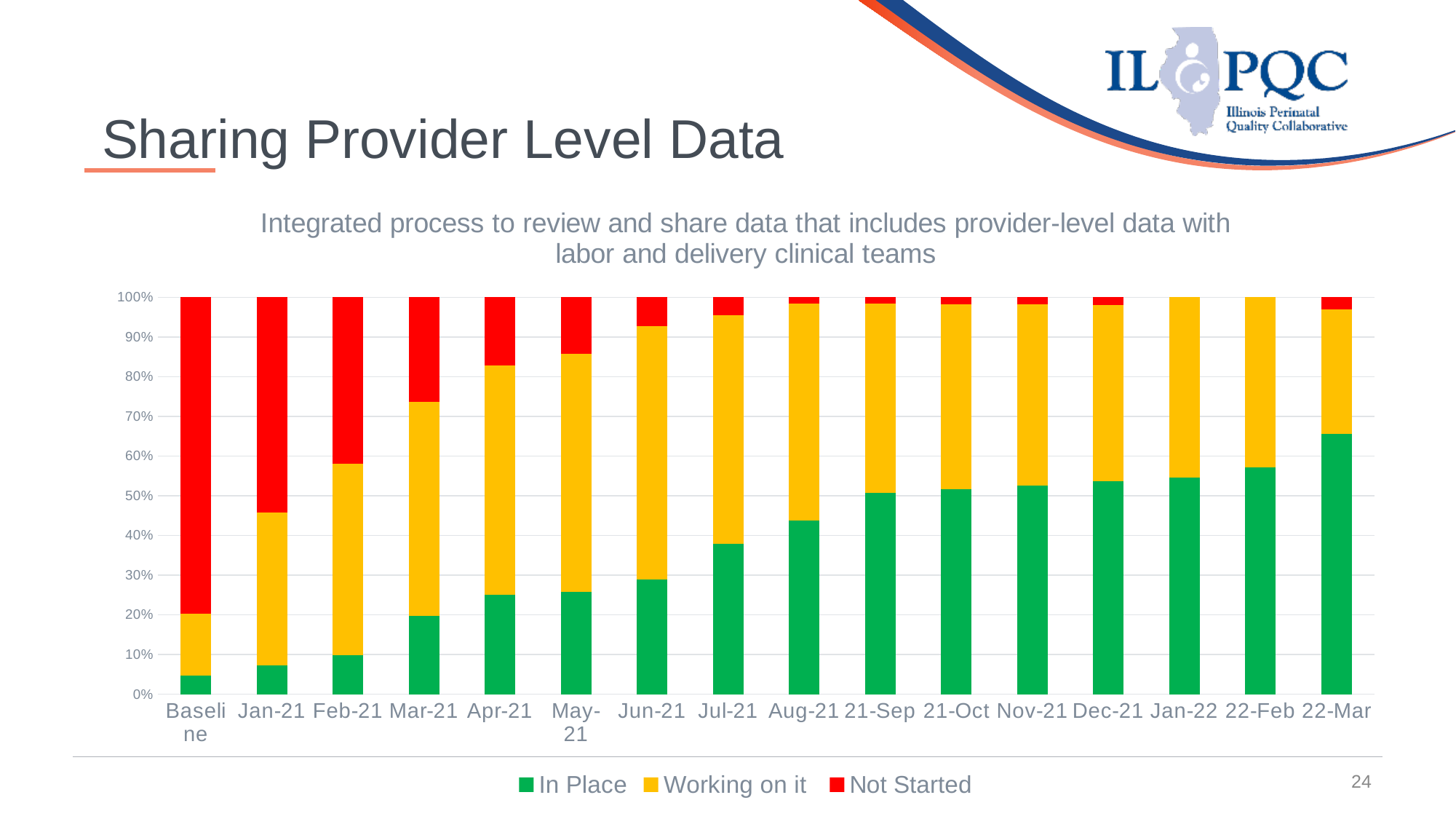
Which is larger, the In Place value for Jan-22 or for Jun-21? Jan-22 How many categories are shown along the x axis of the chart? 16 Is the Not Started value for Baseline greater or less than 70%? greater Does the In Place share rise or fall from Baseline to 22-Mar? Rise Which category has the lowest In Place value? Baseline Which colour represents the Working on it series in the chart? Yellow How many series does the chart's legend list? 3 What kind of chart is shown on the slide? Stacked bar chart Which category has the highest Not Started value? Baseline Which category has the highest In Place value? 22-Mar Is the In Place value for Jan-21 greater or less than 10%? less Is the In Place value for 22-Mar greater or less than 60%? greater